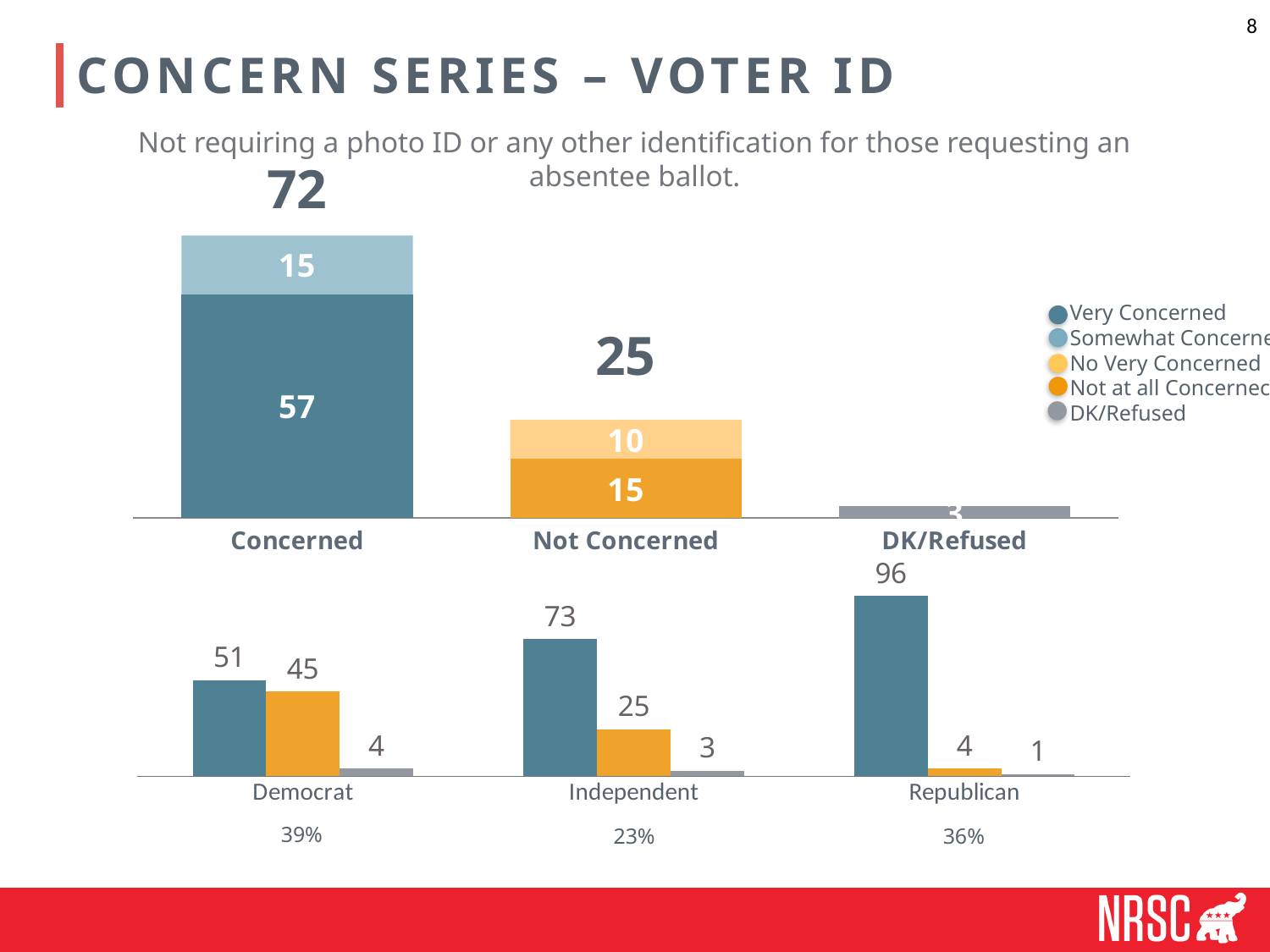
What kind of chart is the bottom chart? Bar chart In the top chart, what is the Somewhat Concerned value within the Concerned bar? 15 In the top chart, what is the difference between the Concerned total and the Not Concerned total? 47 In the top chart, what is the Very Concerned value within the Concerned bar? 57 In the top chart, what is the total for the Not Concerned bar? 25 In the bottom chart, what is the Not at all Concerned value for Democrat? 45 In the top chart, which category has the lowest total? DK/Refused In the bottom chart, which party has the highest Very Concerned value? Republican In the bottom chart, what is the Very Concerned value for Republican? 96 In the top chart, what is the total for the Concerned bar? 72 How many entries does the legend of the top chart list? 5 In the bottom chart, what is the difference between the Very Concerned values for Independent and Democrat? 22